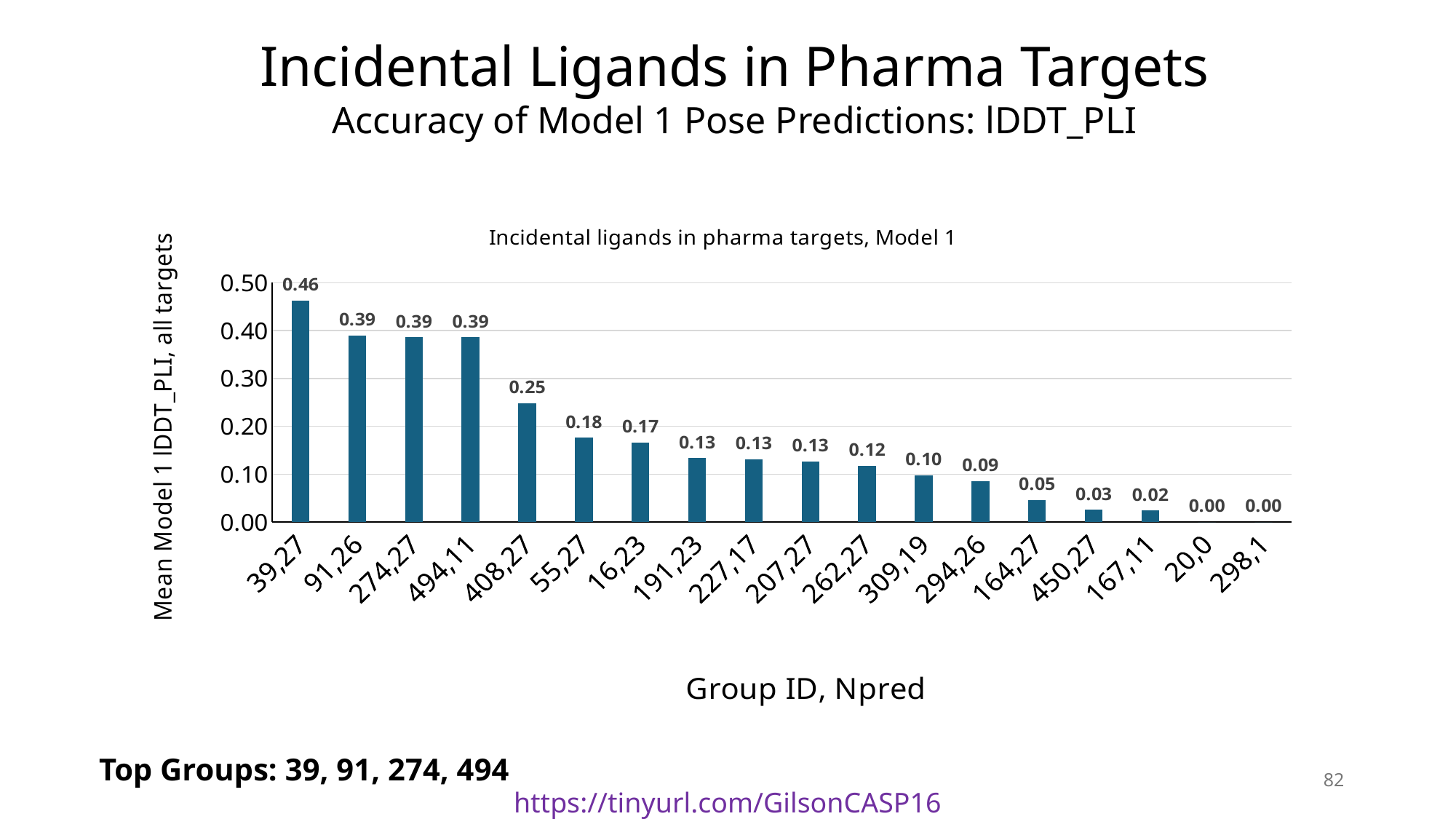
Which is larger, the value for 16,23 or the value for 309,19? 16,23 What kind of chart is shown? bar chart Is the value for 408,27 greater or less than 0.20? greater What is the difference between the values for 408,27 and 55,27? 0.07 What is the difference between the values for 39,27 and 91,26? 0.07 What is the value for group 408,27? 0.25 Do the values rise or fall from left to right along the x axis? fall What is the title printed above the chart plot area? Incidental ligands in pharma targets, Model 1 Which group has the highest mean Model 1 lDDT_PLI? 39,27 What is the value for group 294,26? 0.09 What is the value for group 39,27? 0.46 How many groups are shown on the x axis? 18